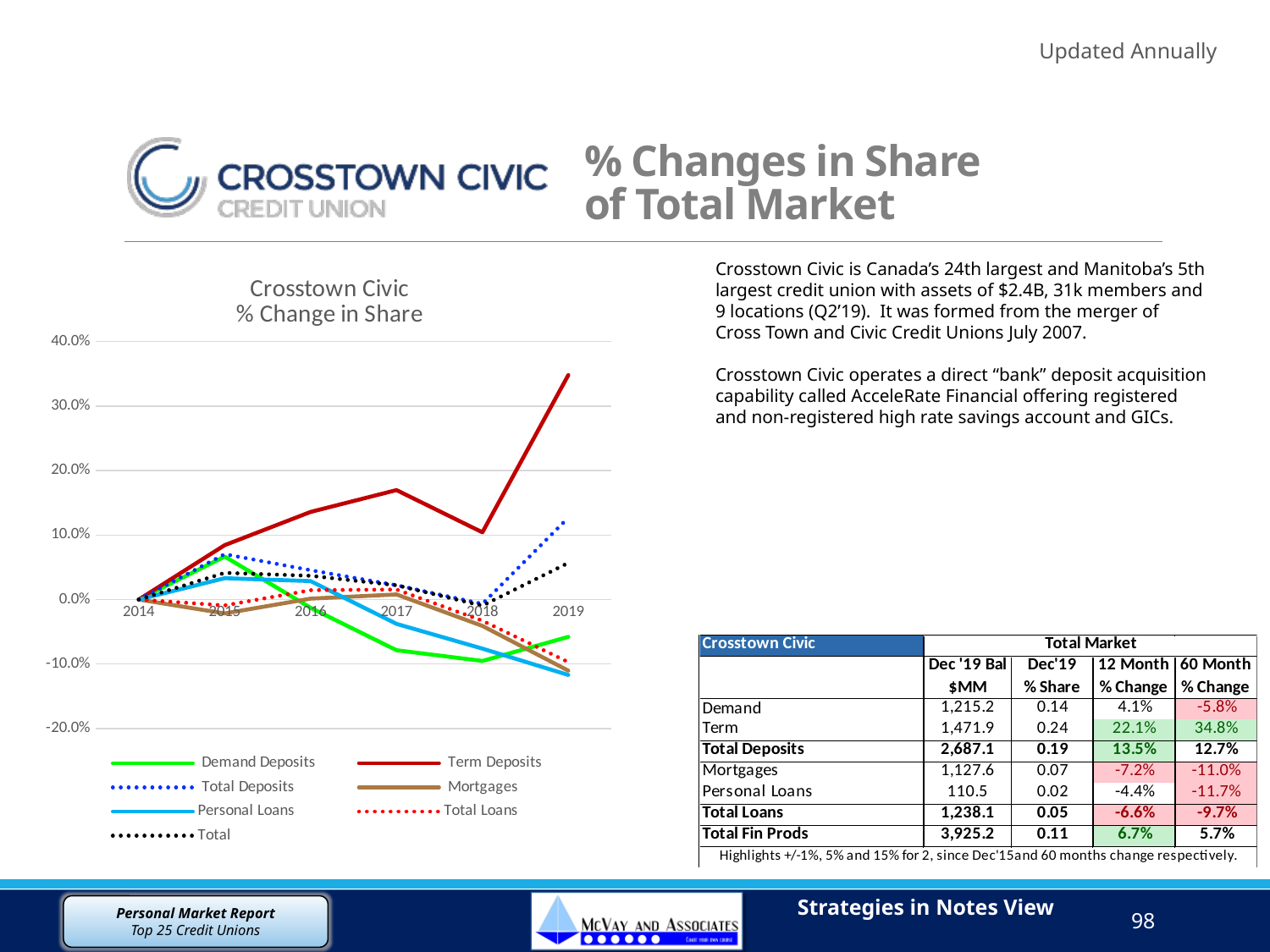
How many series does the chart legend list? 7 Which series has the highest value in 2017? Term Deposits Which series has the highest value in 2019? Term Deposits What is the title of the chart? Crosstown Civic % Change in Share In 2019, which is larger: the value for Term Deposits or the value for Demand Deposits? Term Deposits Does the Term Deposits line rise or fall overall from 2014 to 2019? Rise What kind of chart is shown on the slide? Line chart Is the value for Term Deposits in 2017 greater or less than 10.0%? greater How many years are plotted along the x axis of the chart? 6 Is the value for Demand Deposits in 2017 greater or less than 0.0%? less Which series has the lowest value in 2017? Demand Deposits Is the value for Term Deposits in 2019 greater or less than 30.0%? greater